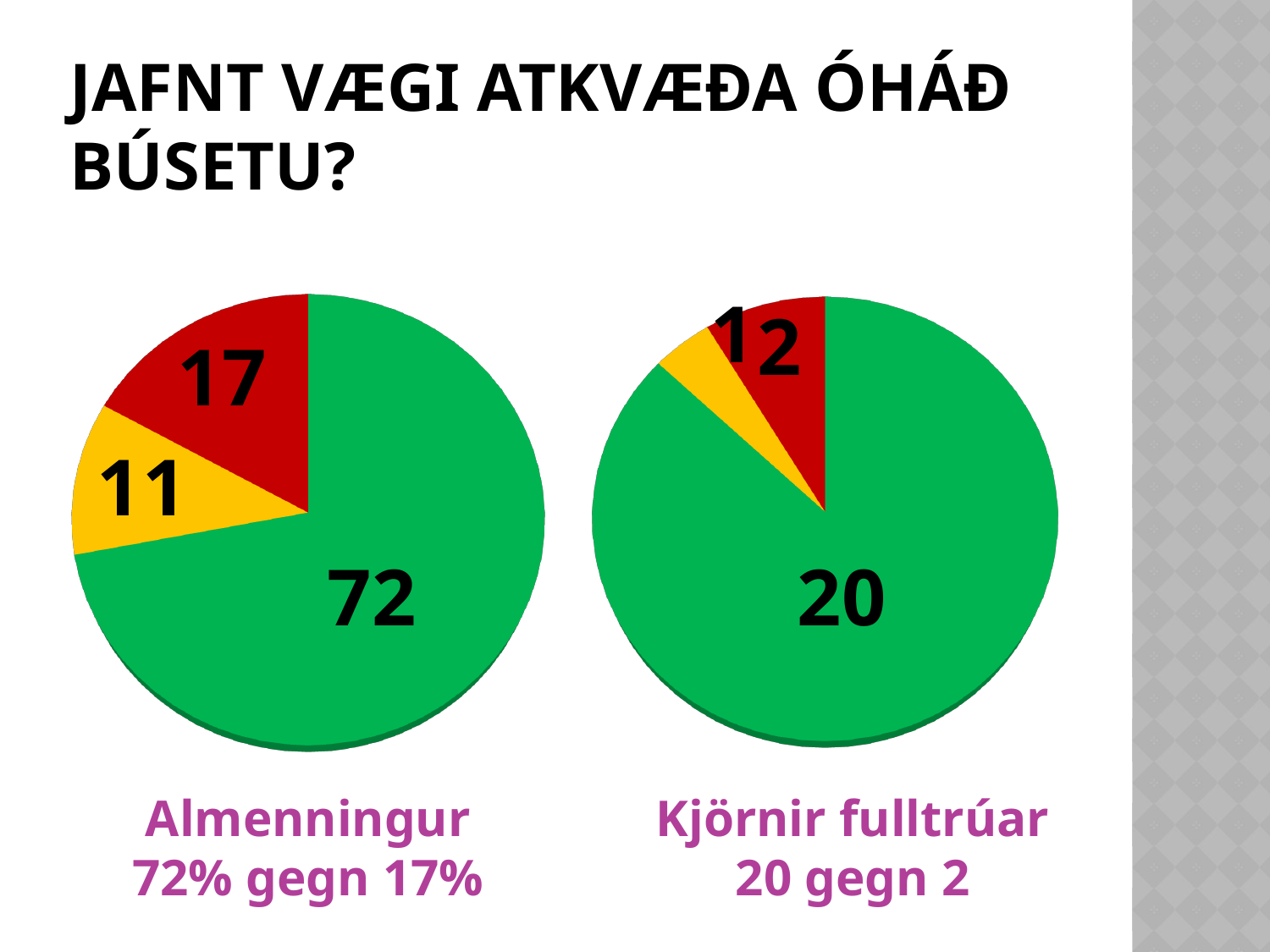
In the Almenningur pie chart, which colour slice is the largest? Green How many pie charts are on the slide? 2 In the Almenningur pie chart, what is the value of the yellow slice? 11 In the Kjörnir fulltrúar pie chart, what is the value of the red slice? 2 In the Almenningur pie chart, what is the value of the red slice? 17 In the Almenningur pie chart, what is the value of the green slice? 72 In the Kjörnir fulltrúar pie chart, what is the value of the green slice? 20 In the Almenningur pie chart, which colour slice is the smallest? Yellow In the Kjörnir fulltrúar pie chart, which is larger, the green slice or the red slice? Green In the Almenningur pie chart, what is the difference between the red slice and the yellow slice? 6 How many slices does the Almenningur pie chart have? 3 What kind of charts are shown on the slide? Pie charts